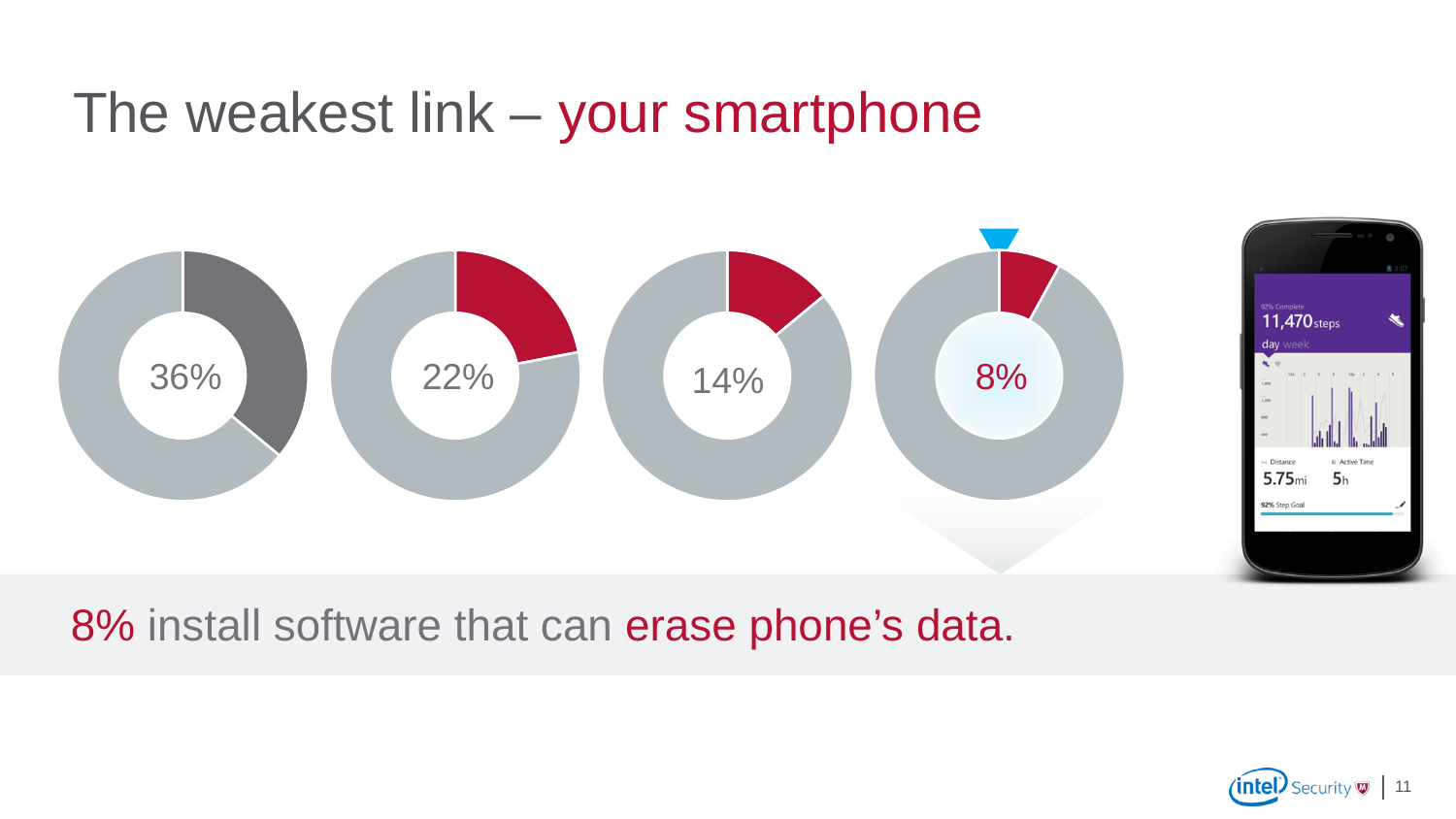
What value is shown in the third donut chart from the left? 14% What is the difference between the value in the leftmost donut chart and the value in the rightmost donut chart? 28% What kind of charts are shown in the row of four charts on the slide? Donut charts Do the values in the donut charts rise or fall from left to right? Fall Which of the four donut charts shows the highest value? The leftmost chart (36%) How many donut charts are shown on the slide? 4 What value is shown in the second donut chart from the left? 22% Which of the four donut charts shows the lowest value? The rightmost chart (8%) Which is larger, the value in the second donut chart or the value in the third donut chart? The second donut chart (22%) What value is shown in the rightmost donut chart? 8% What value is shown in the leftmost donut chart? 36% According to the slide, what share of people install software that can erase the phone's data? 8%